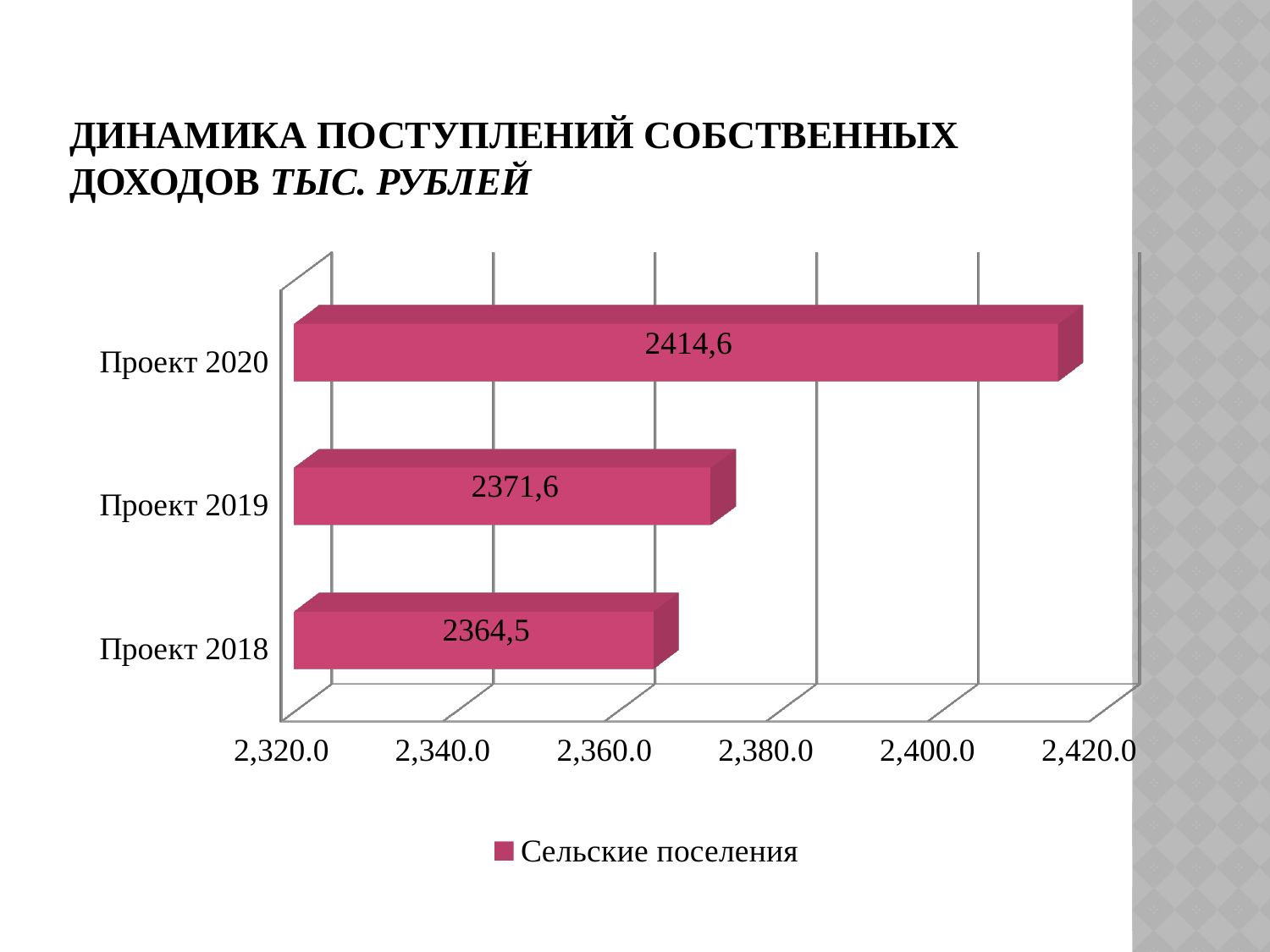
What is the value for Проект 2020? 2414,6 What is the value for Проект 2018? 2364,5 Which category has the highest value? Проект 2020 Is the value for Проект 2020 greater or less than 2,400.0? greater What is the difference between the values for Проект 2020 and Проект 2019? 43,0 How many categories are shown in the chart? 3 What kind of chart is shown on the slide? bar chart Which category has the lowest value? Проект 2018 What is the difference between the values for Проект 2020 and Проект 2018? 50,1 What is the value for Проект 2019? 2371,6 What series name does the legend list? Сельские поселения Which is larger, the value for Проект 2019 or the value for Проект 2018? Проект 2019